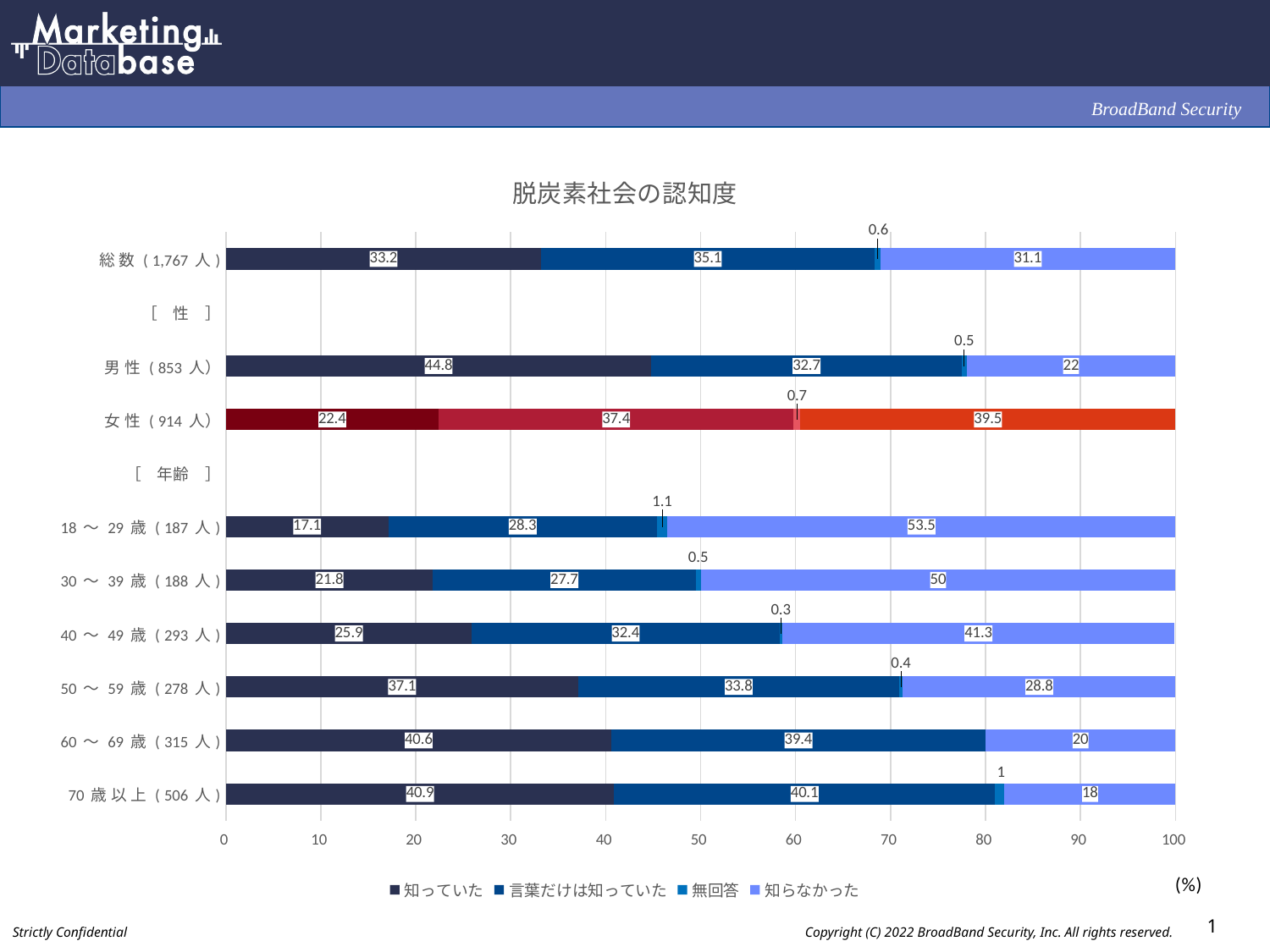
What is the value of 言葉だけは知っていた for 女性 (914人)? 37.4 Which age group has the lowest value for 知っていた? 18～29歳 (187人) What type of chart is shown on the slide? Stacked bar chart What is the value of 無回答 for 総数 (1,767人)? 0.6 What is the difference between the 知っていた values for 男性 (853人) and 女性 (914人)? 22.4 How many series does the legend list? 4 What is the title of the chart? 脱炭素社会の認知度 Which is larger, the 知らなかった value for 30～39歳 (188人) or for 40～49歳 (293人)? 30～39歳 (188人) Which age group has the highest value for 知らなかった? 18～29歳 (187人) What is the value of 知っていた for 男性 (853人)? 44.8 What is the value of 知らなかった for 18～29歳 (187人)? 53.5 Does the 知っていた value generally rise or fall as the age groups go from 18～29歳 to 70歳以上? Rise